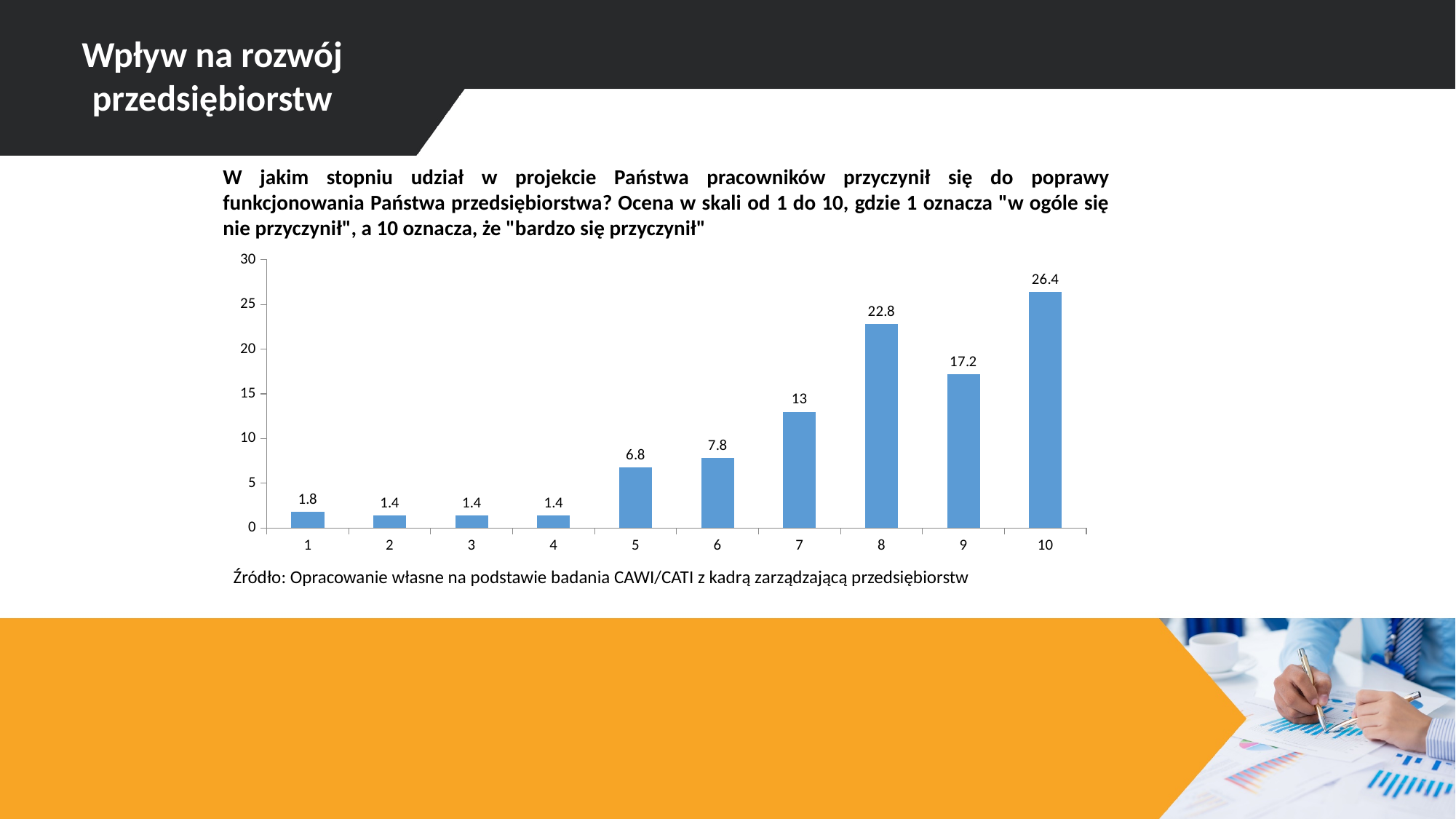
How many rating categories are shown on the x axis? 10 Which is larger, the value for rating 8 or the value for rating 9? rating 8 Is the value for rating 8 greater or less than 20? greater What is the value for rating 1? 1.8 What is the value for rating 10? 26.4 What kind of chart is shown on the slide? bar chart Which rating has the highest value? 10 Is the value for rating 6 greater or less than 10? less What is the difference between the values for rating 10 and rating 8? 3.6 What is the value for rating 7? 13 What is the difference between the values for rating 9 and rating 5? 10.4 Do the values generally rise or fall from rating 4 to rating 8? rise